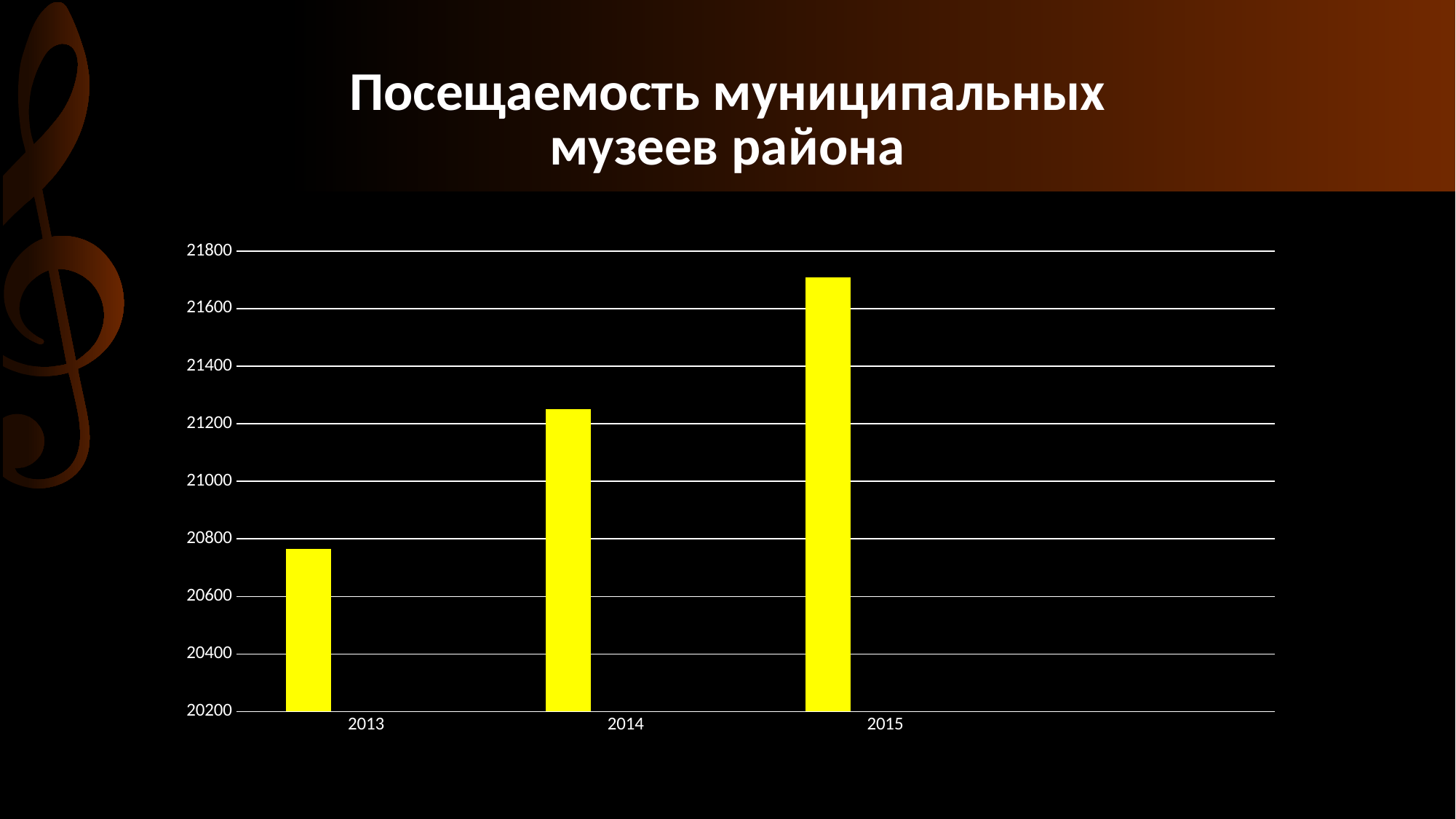
Which year has the highest value? 2015 Which is larger, the value for 2014 or the value for 2015? 2015 Is the value for 2014 greater or less than 21000? greater Do the values rise or fall from 2013 to 2015? rise What kind of chart is shown on the slide? bar chart How many years (categories) are shown on the x axis? 3 What colour are the bars in the chart? yellow Is the value for 2013 greater or less than 20600? greater What is the title of the chart? Посещаемость муниципальных музеев района Is the value for 2013 greater or less than 21000? less Which year has the lowest value? 2013